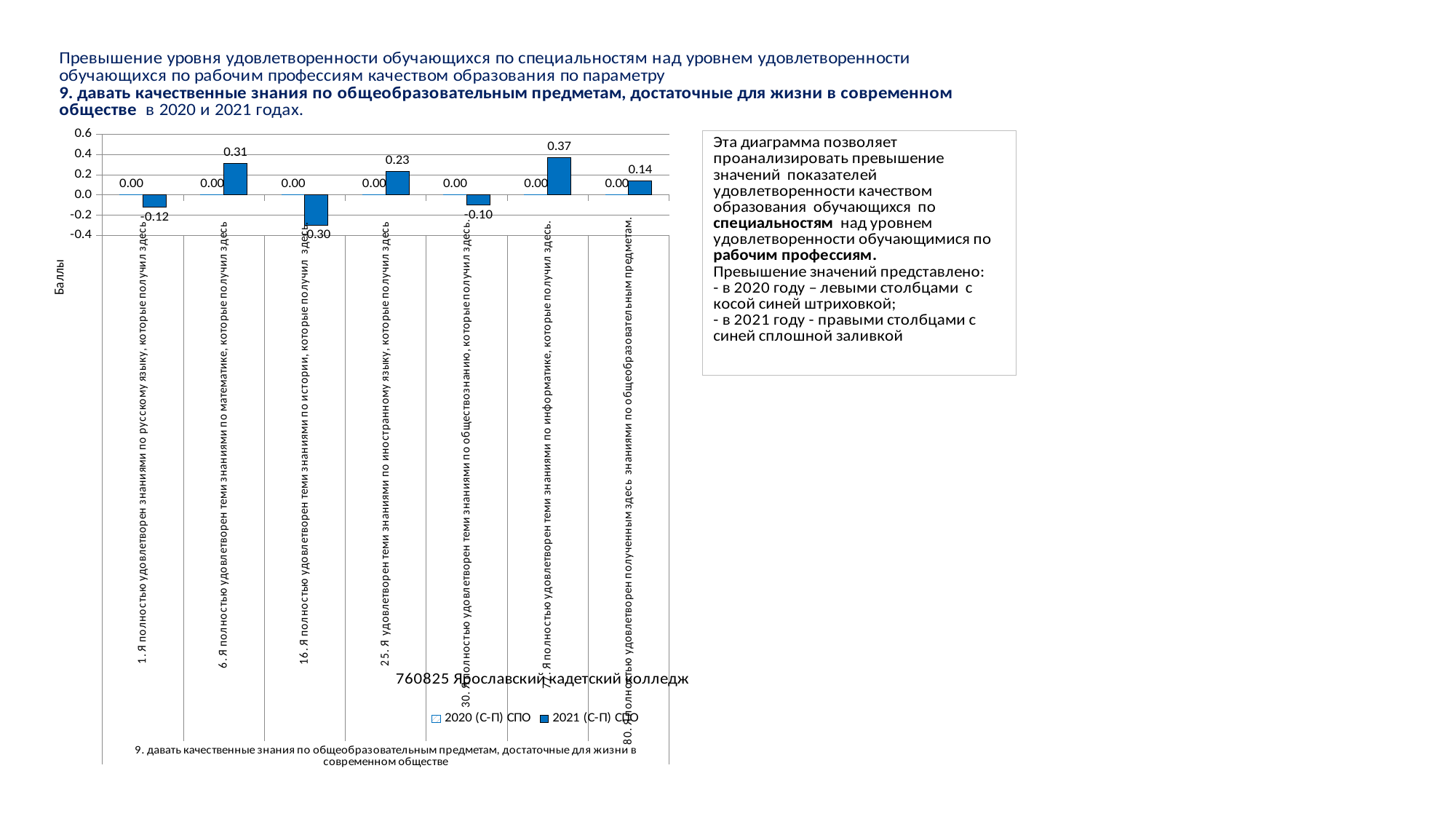
Which category has the lowest 2021 (С-П) СПО value? 16. Я полностью удовлетворен теми знаниями по истории, которые получил здесь Which is larger for 2021 (С-П) СПО: the value for foreign language (25.) or the value for general education subjects (80.)? 25. (foreign language), 0.23 What is the 2021 (С-П) СПО value for the category about knowledge of mathematics (6. ... по математике)? 0.31 What is the difference between the 2021 (С-П) СПО values for informatics (77.) and mathematics (6.)? 0.06 What is the 2020 (С-П) СПО value for the category about knowledge of the Russian language (1. ... по русскому языку)? 0.00 Which category has the highest 2021 (С-П) СПО value? 77. Я полностью удовлетворен теми знаниями по информатике, которые получил здесь What is the 2021 (С-П) СПО value for the category about knowledge of informatics (77. ... по информатике)? 0.37 What is the label of the vertical axis of the chart? Баллы What kind of chart is shown on the slide? bar chart How many series does the chart legend list? 2 What is the 2021 (С-П) СПО value for the category about knowledge of history (16. ... по истории)? -0.30 How many categories are plotted on the x axis of the chart? 7